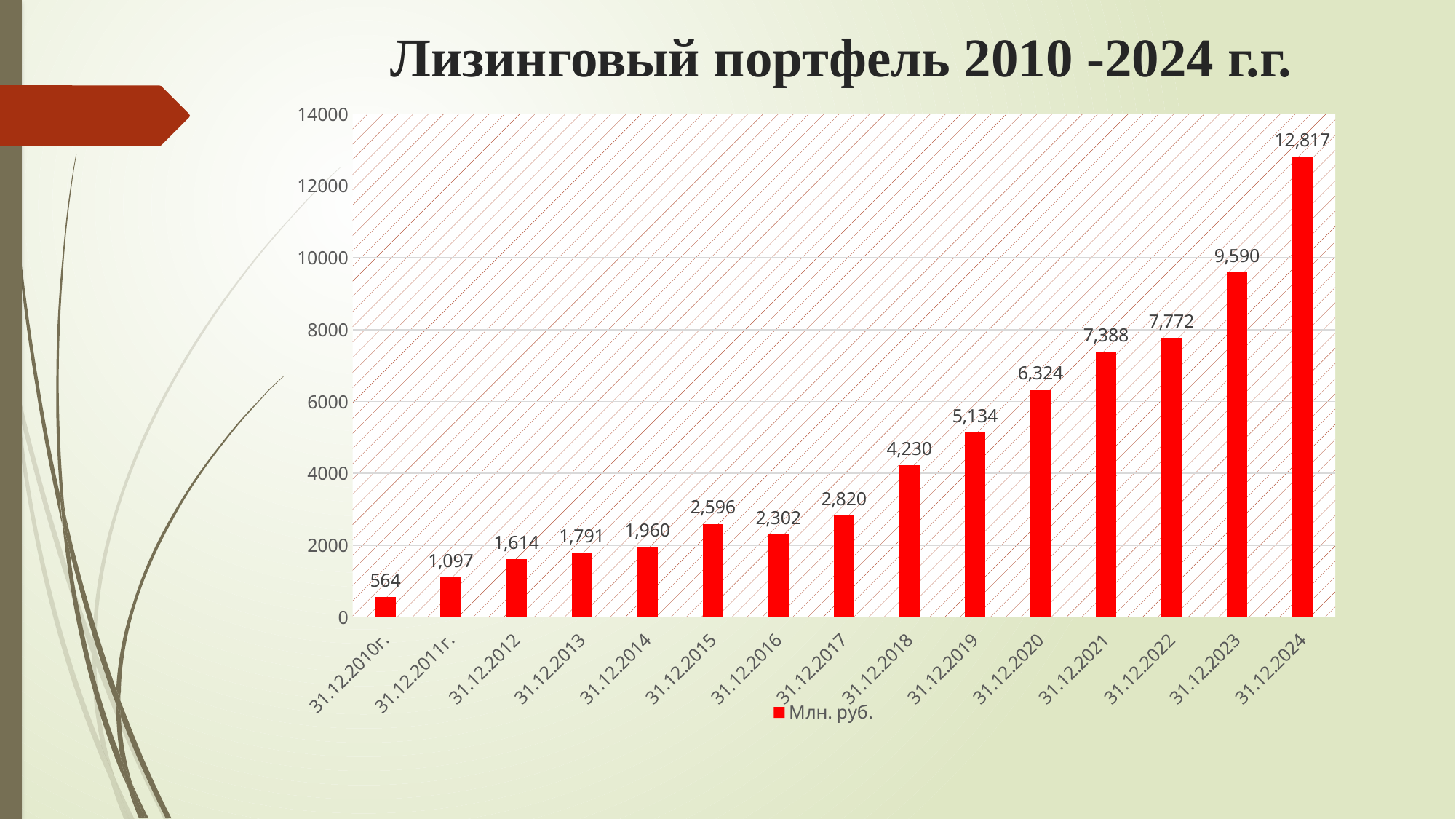
What is the difference between the values for 31.12.2024 and 31.12.2023? 3,227 How many series does the legend list? 1 Is the value for 31.12.2021 greater or less than 8000? less What is the value for 31.12.2024? 12,817 Which date has the highest value? 31.12.2024 What is the value for 31.12.2016? 2,302 What is the value for 31.12.2020? 6,324 How many dates are shown on the x axis? 15 What type of chart is shown on the slide? Bar chart Which is larger, the value for 31.12.2015 or the value for 31.12.2016? 31.12.2015 What is the title of the chart? Лизинговый портфель 2010 -2024 г.г. Which date has the lowest value? 31.12.2010г.